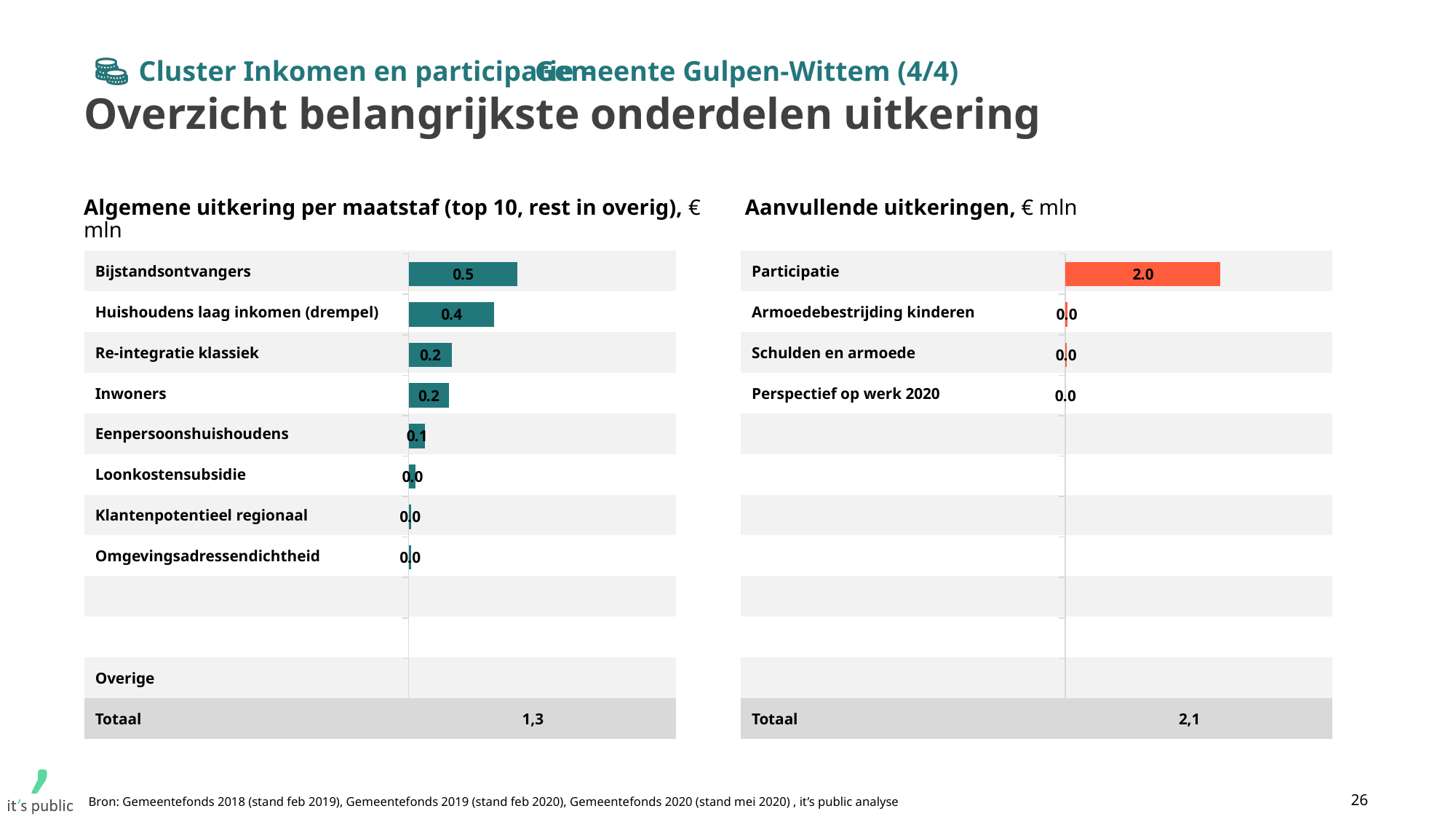
In the chart 'Algemene uitkering per maatstaf', what is the value for Huishoudens laag inkomen (drempel)? 0.4 In the chart 'Aanvullende uitkeringen', which category has the highest value? Participatie In the chart 'Aanvullende uitkeringen', how many categories are listed? 4 What kind of chart is 'Algemene uitkering per maatstaf'? Bar chart In the chart 'Algemene uitkering per maatstaf', which is larger: Huishoudens laag inkomen (drempel) or Eenpersoonshuishoudens? Huishoudens laag inkomen (drempel) In the chart 'Aanvullende uitkeringen', what is the value for Participatie? 2.0 In the chart 'Algemene uitkering per maatstaf', what is the value for Bijstandsontvangers? 0.5 In the chart 'Algemene uitkering per maatstaf', what is the difference between Bijstandsontvangers and Huishoudens laag inkomen (drempel)? 0.1 What is the Totaal shown under the chart 'Aanvullende uitkeringen'? 2,1 In the chart 'Aanvullende uitkeringen', what is the value for Perspectief op werk 2020? 0.0 In the chart 'Algemene uitkering per maatstaf', which category has the highest value? Bijstandsontvangers What is the Totaal shown under the chart 'Algemene uitkering per maatstaf'? 1,3